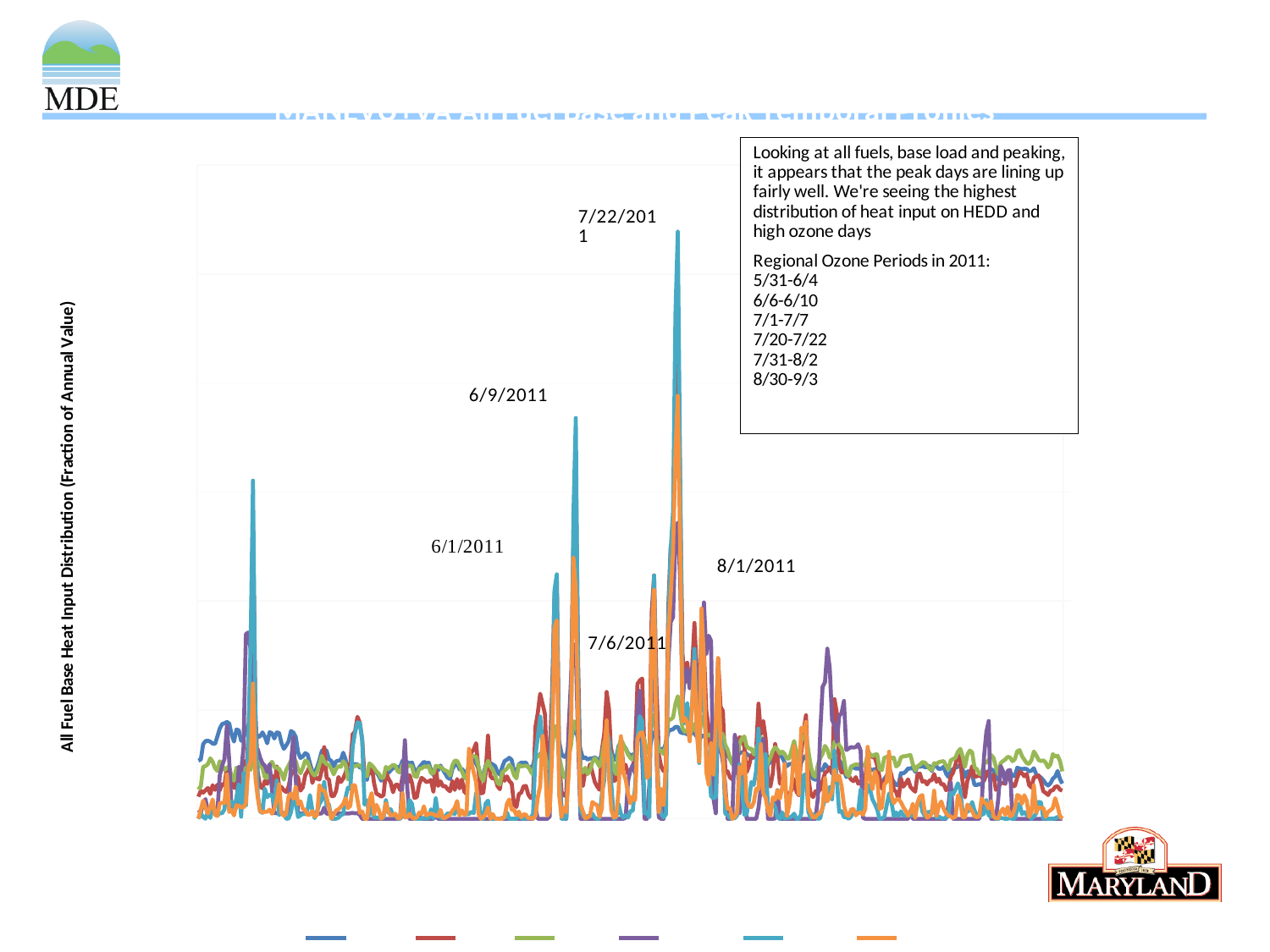
Which peak is higher, the one labelled 6/9/2011 or the one labelled 6/1/2011? 6/9/2011 What colour is the line that reaches the highest peak on the chart? teal How many date labels are annotated on the chart? 5 How many series does the legend at the bottom of the chart show? 6 Which peak is higher, the one labelled 7/22/2011 or the one labelled 6/9/2011? 7/22/2011 What is the title of the vertical axis of the chart? All Fuel Base Heat Input Distribution (Fraction of Annual Value) What kind of chart is shown on the slide? line chart Which labelled date marks the tallest peak in the chart? 7/22/2011